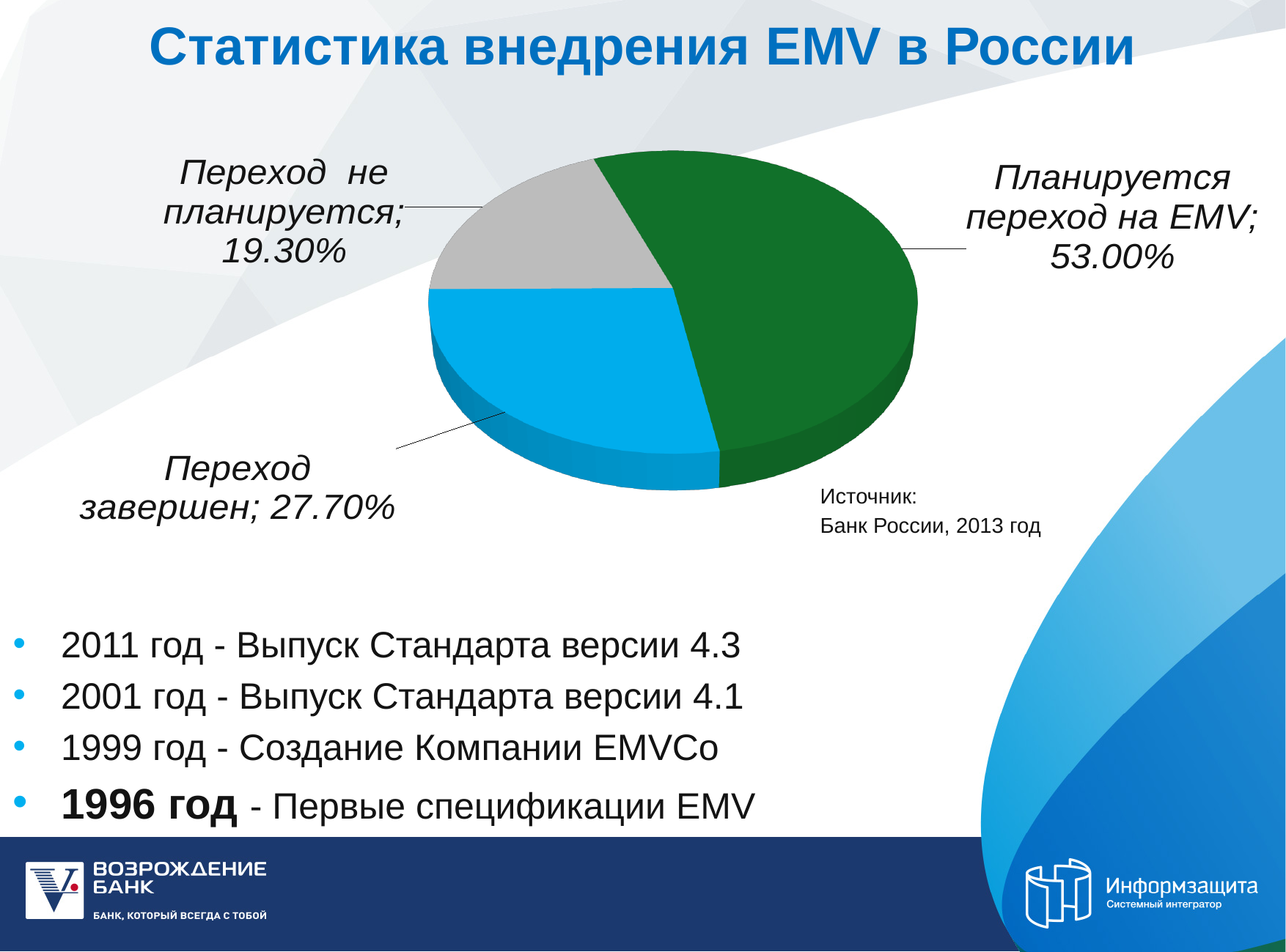
Which slice of the pie is the smallest? Переход не планируется What share of the pie is labelled "Переход завершен"? 27.70% What share of the pie is labelled "Переход не планируется"? 19.30% What colour is the "Планируется переход на EMV" slice? green What share of the pie is labelled "Планируется переход на EMV"? 53.00% What source is cited for the chart data? Банк России, 2013 год How many slices does the pie chart have? 3 What is the difference between the "Переход завершен" share and the "Переход не планируется" share? 8.40% What kind of chart is shown on the slide? pie chart Which slice of the pie is the largest? Планируется переход на EMV Which is larger: the "Переход завершен" slice or the "Переход не планируется" slice? Переход завершен What is the difference between the "Планируется переход на EMV" share and the "Переход завершен" share? 25.30%